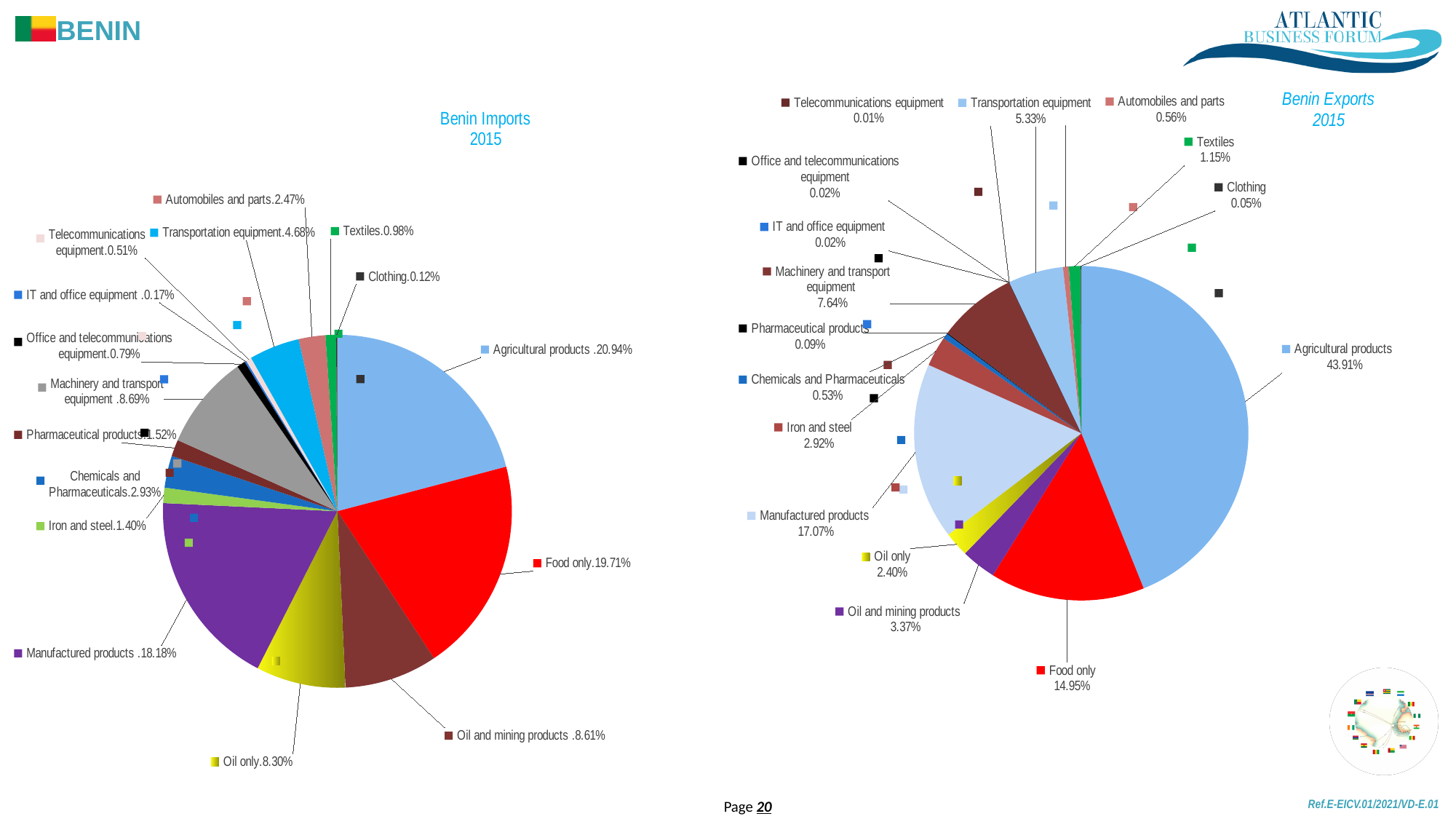
In the Benin Exports 2015 chart, which is larger: Food only or Manufactured products? Manufactured products In the Benin Imports 2015 chart, what share does Oil only have? 8.30% In the Benin Imports 2015 chart, what share do Agricultural products have? 20.94% In the Benin Imports 2015 chart, which category has the smallest share? Clothing How many categories are shown in the Benin Imports 2015 chart? 16 In the Benin Exports 2015 chart, which category has the largest share? Agricultural products In the Benin Exports 2015 chart, which category has the smallest share? Telecommunications equipment In the Benin Imports 2015 chart, which is larger: Transportation equipment or Automobiles and parts? Transportation equipment What kind of chart is the Benin Exports 2015 chart? Pie chart In the Benin Imports 2015 chart, what is the difference between the shares of Agricultural products and Food only? 1.23% In the Benin Exports 2015 chart, what share do Manufactured products have? 17.07% In the Benin Exports 2015 chart, what share does Machinery and transport equipment have? 7.64%